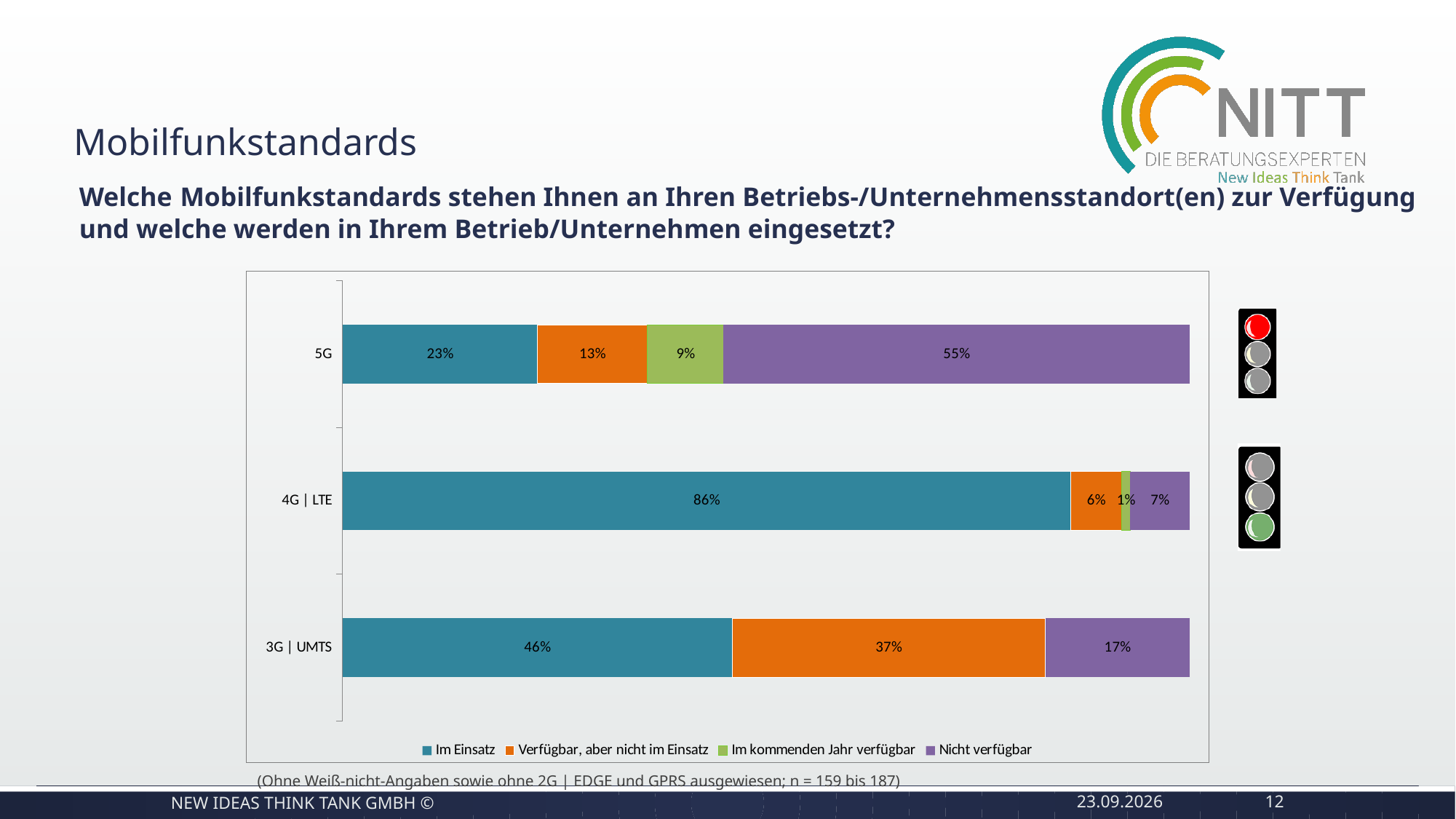
What percentage of respondents have 5G 'Im Einsatz'? 23% Which mobile standard has the lowest 'Im Einsatz' share? 5G Which is larger: the 'Verfügbar, aber nicht im Einsatz' value for 5G or for 3G | UMTS? 3G | UMTS What is the difference between the 'Nicht verfügbar' values for 5G and 3G | UMTS? 38% How many mobile standards (categories) are shown in the chart? 3 What is the 'Nicht verfügbar' value for 5G? 55% What is the 'Im Einsatz' value for 4G | LTE? 86% How many series does the legend list? 4 What is the 'Im kommenden Jahr verfügbar' value for 4G | LTE? 1% What is the 'Verfügbar, aber nicht im Einsatz' value for 3G | UMTS? 37% Which mobile standard has the highest 'Im Einsatz' share? 4G | LTE What type of chart is shown on the slide? Stacked bar chart